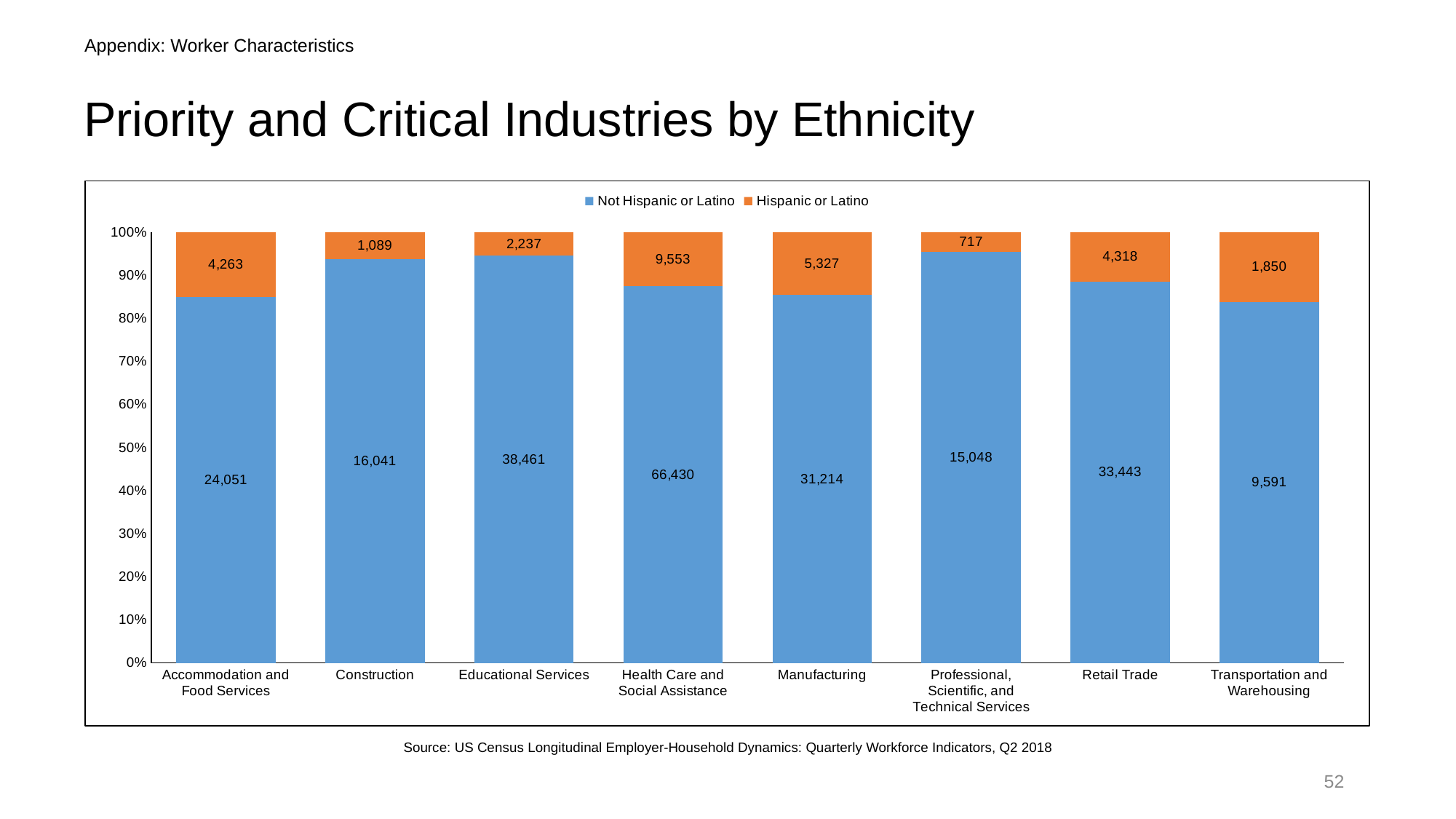
Which industry has the highest Hispanic or Latino value? Health Care and Social Assistance What is the Not Hispanic or Latino value for Transportation and Warehousing? 9,591 Which industry has the lowest Hispanic or Latino value? Professional, Scientific, and Technical Services How many series does the legend list? 2 Is the Not Hispanic or Latino share of the Construction bar greater or less than 90%? greater What is the total of the two values in the Construction bar? 17,130 What is the Not Hispanic or Latino value for Health Care and Social Assistance? 66,430 What is the difference between the Hispanic or Latino values for Health Care and Social Assistance and Manufacturing? 4,226 How many industries are shown on the x axis? 8 Which industry has the lowest Not Hispanic or Latino value? Transportation and Warehousing What is the Hispanic or Latino value for Retail Trade? 4,318 Which is larger, the Not Hispanic or Latino value for Educational Services or for Retail Trade? Educational Services